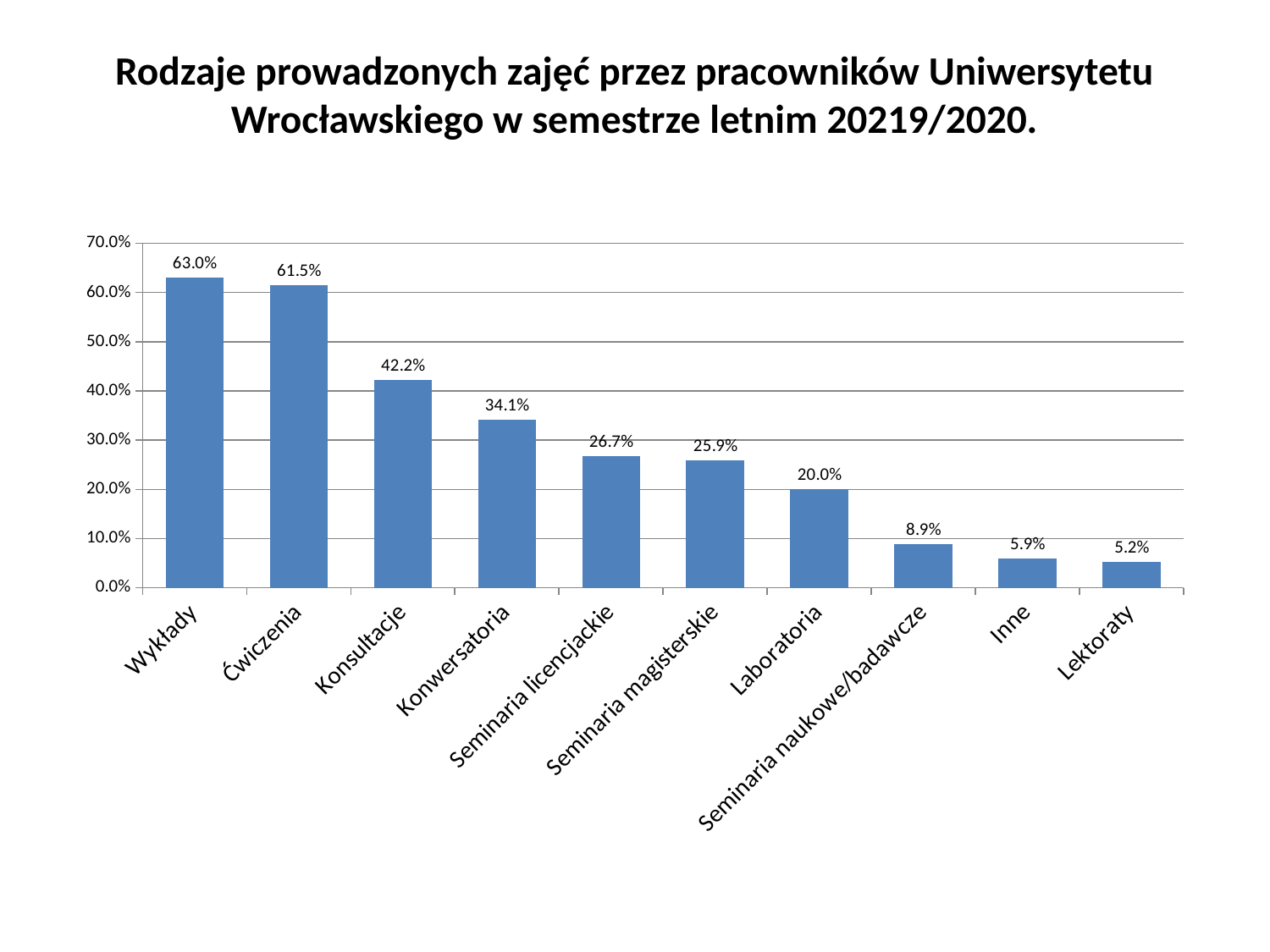
Which is larger, the value for Seminaria licencjackie or the value for Seminaria magisterskie? Seminaria licencjackie Is the value for Konsultacje greater or less than 40.0%? greater Which category has the highest value? Wykłady What kind of chart is shown on the slide? bar chart What is the value for Seminaria naukowe/badawcze? 8.9% Do the values rise or fall from left to right along the x axis? fall What is the difference between the values for Wykłady and Ćwiczenia? 1.5% How many categories are shown on the x axis? 10 Which category has the lowest value? Lektoraty What is the difference between the values for Konwersatoria and Laboratoria? 14.1% What is the value for Konsultacje? 42.2% What is the value for Wykłady? 63.0%